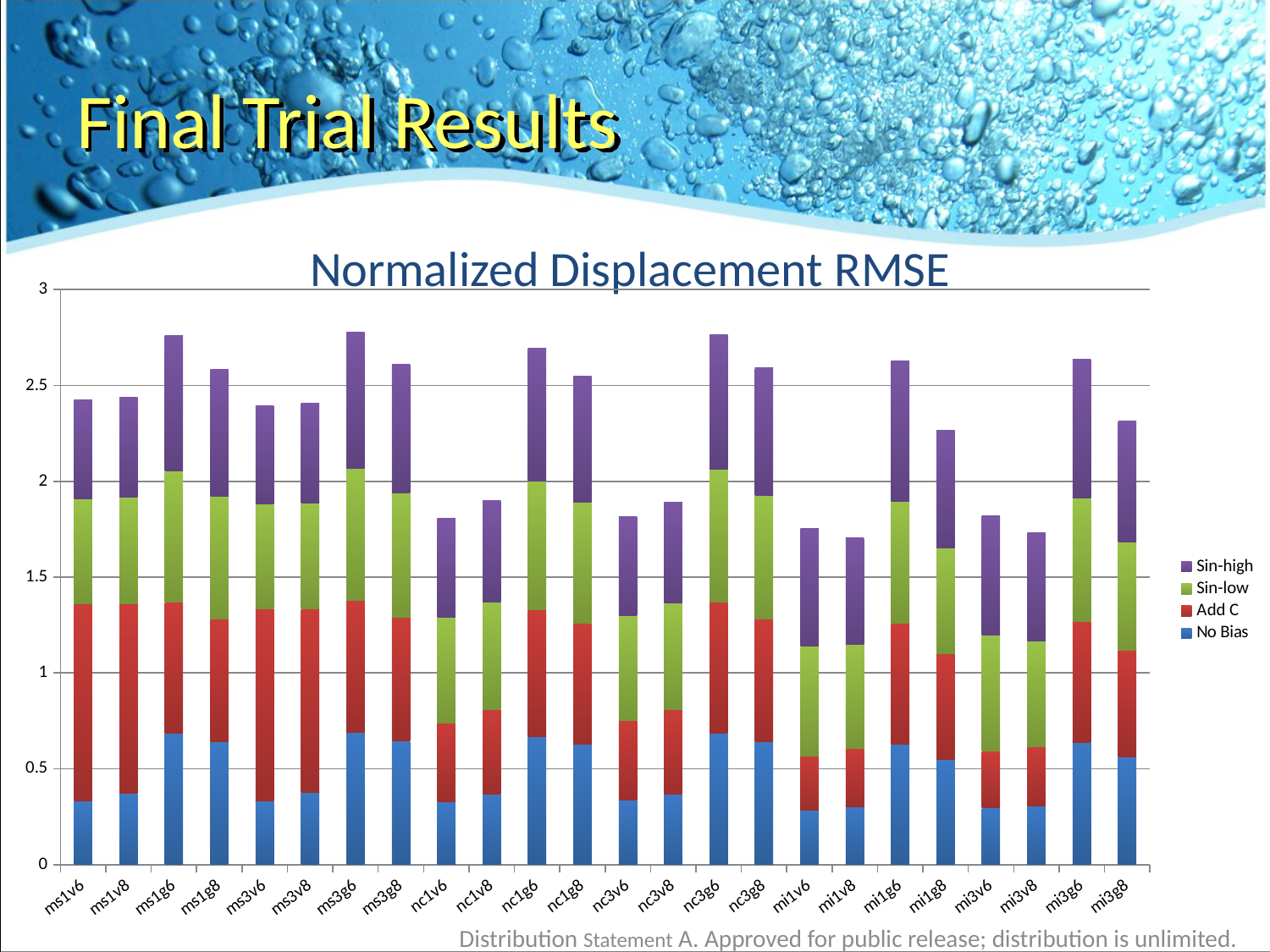
Which series is shown in purple in the legend? Sin-high Which has the larger total stacked value, ms1g6 or nc1v6? ms1g6 Is the total stacked value for nc1v6 greater or less than 2? less Is the No Bias value for mi1v6 greater or less than 0.5? less Which has the larger total stacked value, mi1g6 or mi1g8? mi1g6 What is the title of the chart? Normalized Displacement RMSE Is the total stacked value for mi1g8 greater or less than 2? greater How many series does the legend list? 4 What kind of chart is shown on the slide? Stacked bar chart How many categories are shown along the x axis? 24